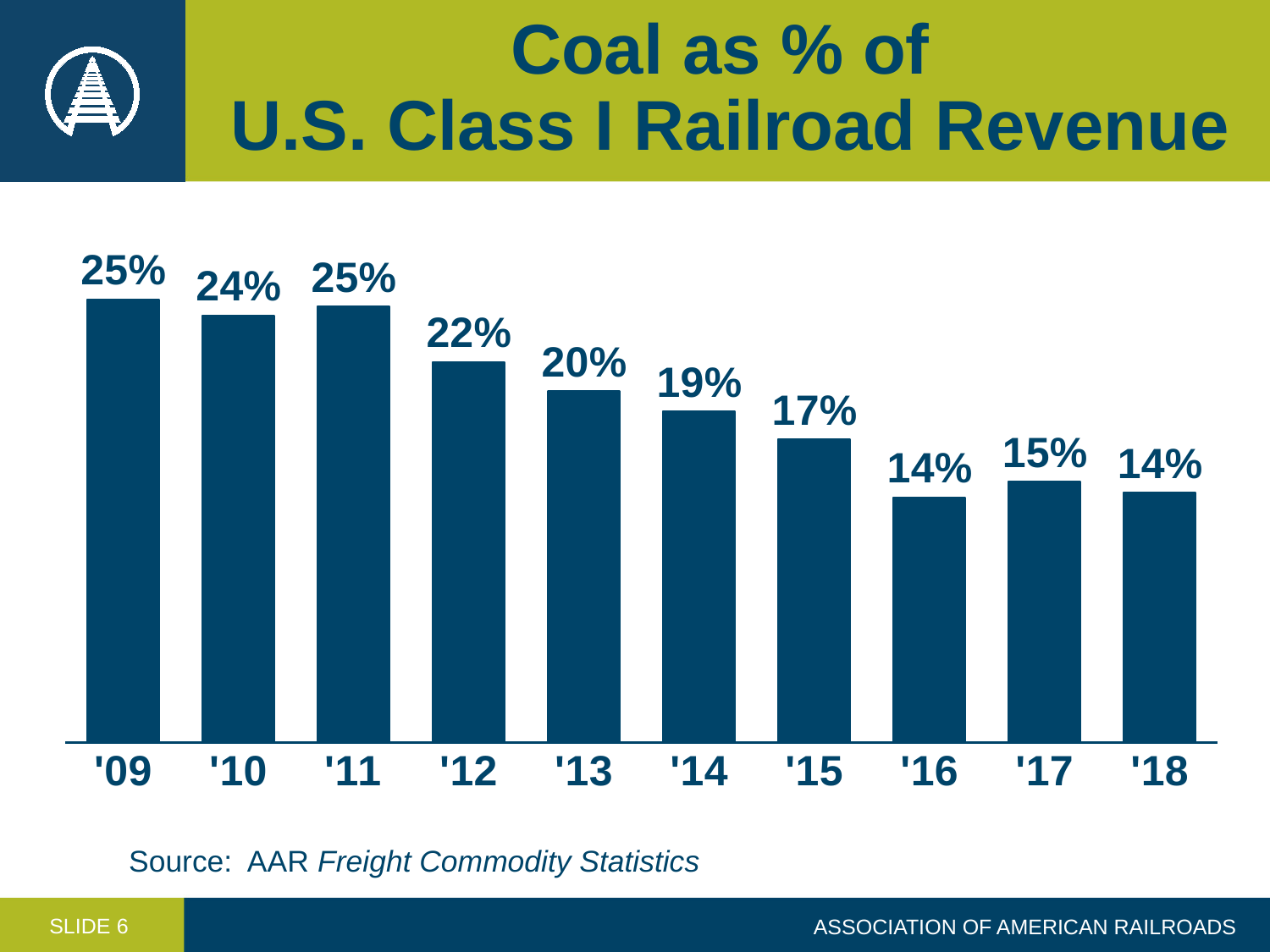
What is the difference between the values for '09 and '18? 11 percentage points How many years are shown on the x axis? 10 What is the difference between the values for '13 and '14? 1 percentage point What is the value for '18? 14% What is the value for '12? 22% What kind of chart is this? Bar chart Do the values generally rise or fall from '09 to '18? Fall What source is cited for the chart? AAR Freight Commodity Statistics What is the title of the chart? Coal as % of U.S. Class I Railroad Revenue Which is larger, the value for '10 or the value for '17? '10 Which year has the lowest value? '16 and '18 (both 14%) What is the value for '15? 17%